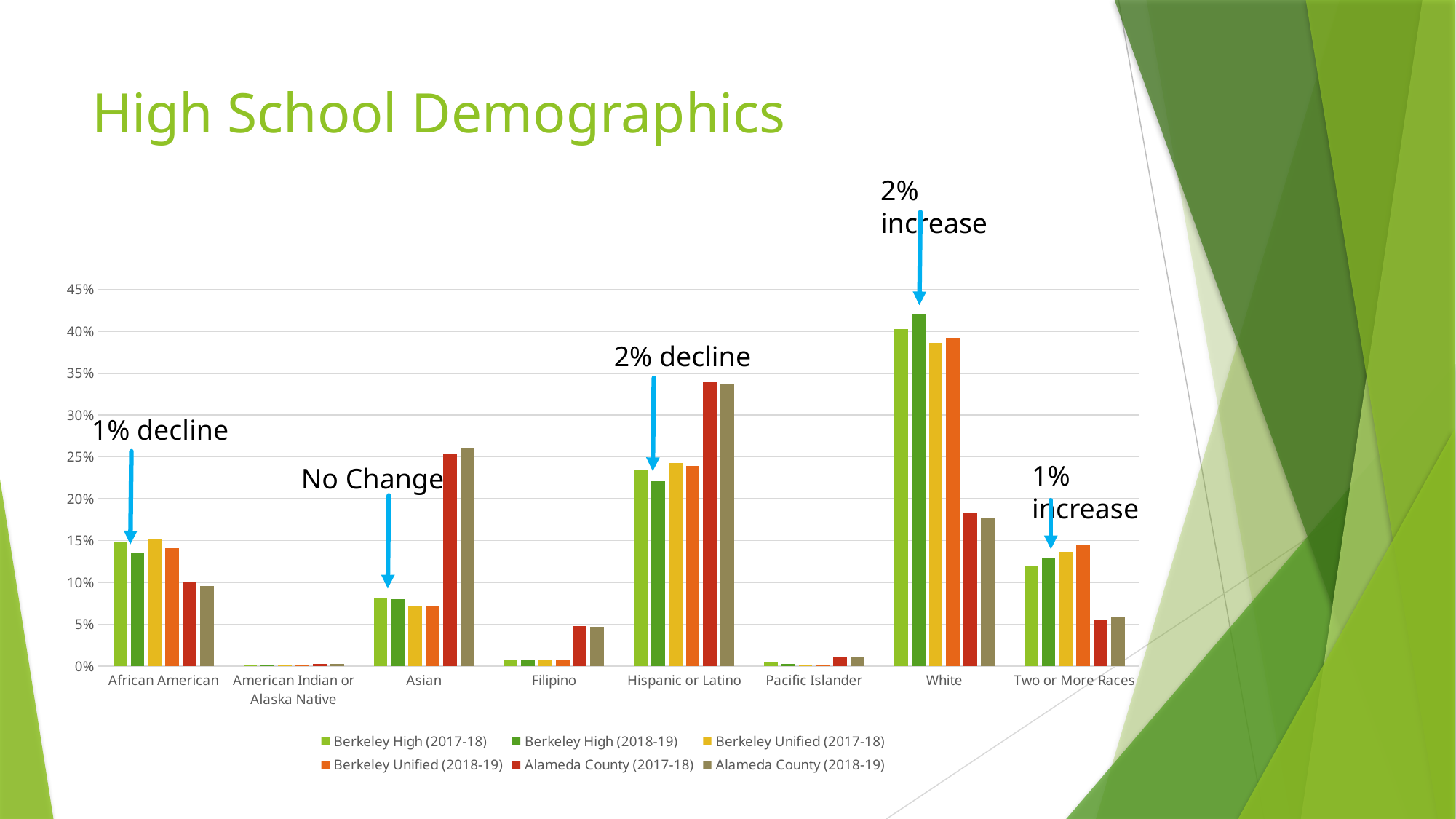
How many series does the legend list? 6 How many categories are shown on the x axis of the chart? 8 Is the value for White in the Berkeley High (2018-19) series greater or less than 40%? greater Is the value for Asian in the Berkeley High (2017-18) series greater or less than 10%? less What kind of chart is shown on the slide? Bar chart What is the title of the slide containing the chart? High School Demographics Is the value for White in the Alameda County (2017-18) series greater or less than 20%? less What annotation is written above the Asian category in the chart? No Change For Asian, which is larger: Alameda County (2018-19) or Berkeley High (2018-19)? Alameda County (2018-19) For Hispanic or Latino, which is larger: Alameda County (2017-18) or Berkeley High (2017-18)? Alameda County (2017-18) Which category has the tallest bars in the chart? White